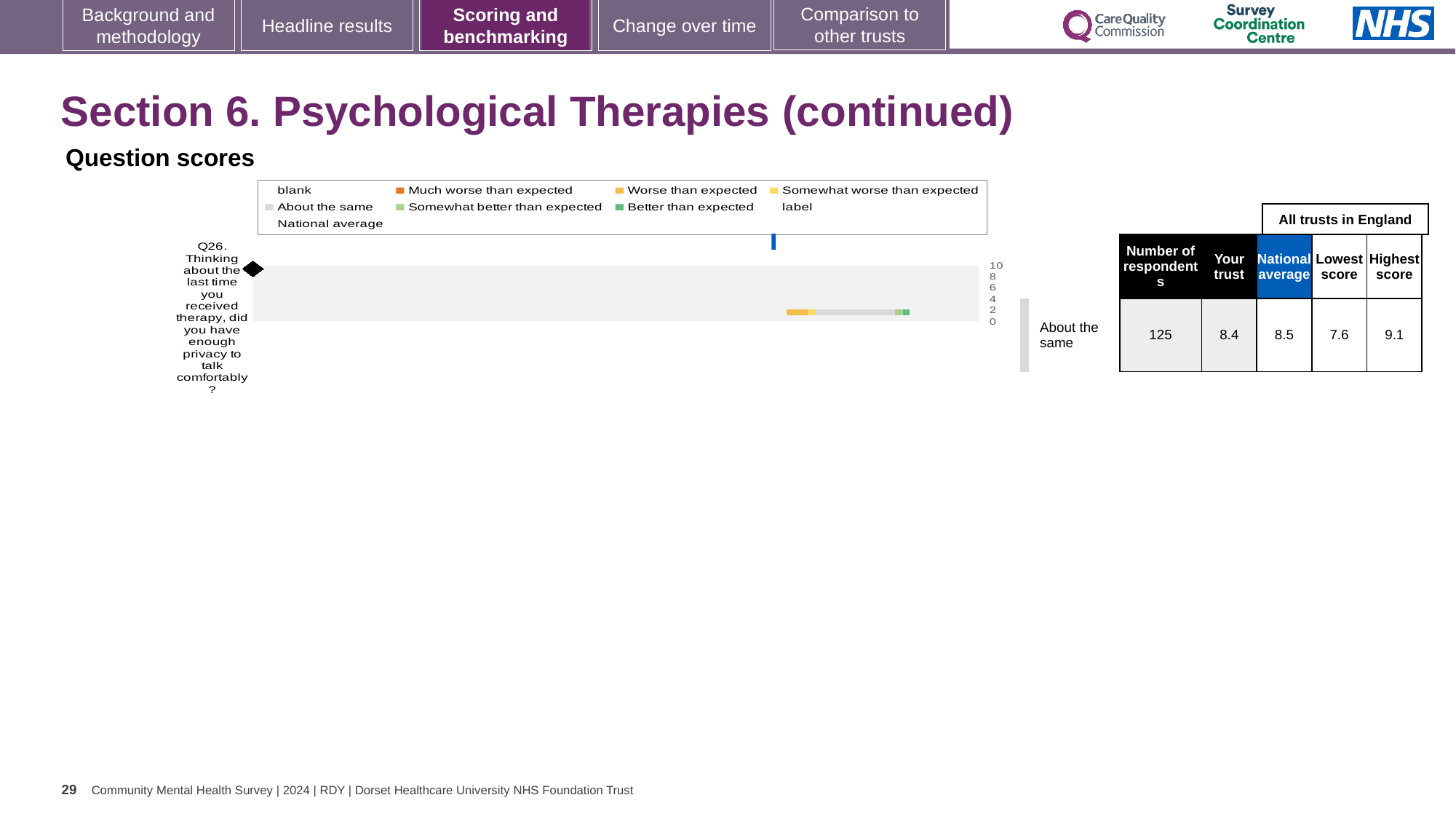
What benchmark category is the trust's Q26 score assigned to, as labelled next to the chart? About the same According to the table beside the chart, what is the lowest score among all trusts in England for Q26? 7.6 How many respondents answered Q26, according to the table beside the chart? 125 According to the table beside the chart, what is the 'Your trust' score for Q26? 8.4 What kind of chart is shown under 'Question scores'? bar chart According to the table beside the chart, what is the highest score among all trusts in England for Q26? 9.1 Which is larger for Q26: the 'Your trust' score or the national average? National average What is the maximum value shown on the chart's score axis? 10 How many survey questions are plotted in the chart? 1 What is the difference between the highest score and the lowest score for Q26 in the table beside the chart? 1.5 According to the table beside the chart, what is the national average score for Q26? 8.5 Which question number is plotted in the chart? Q26